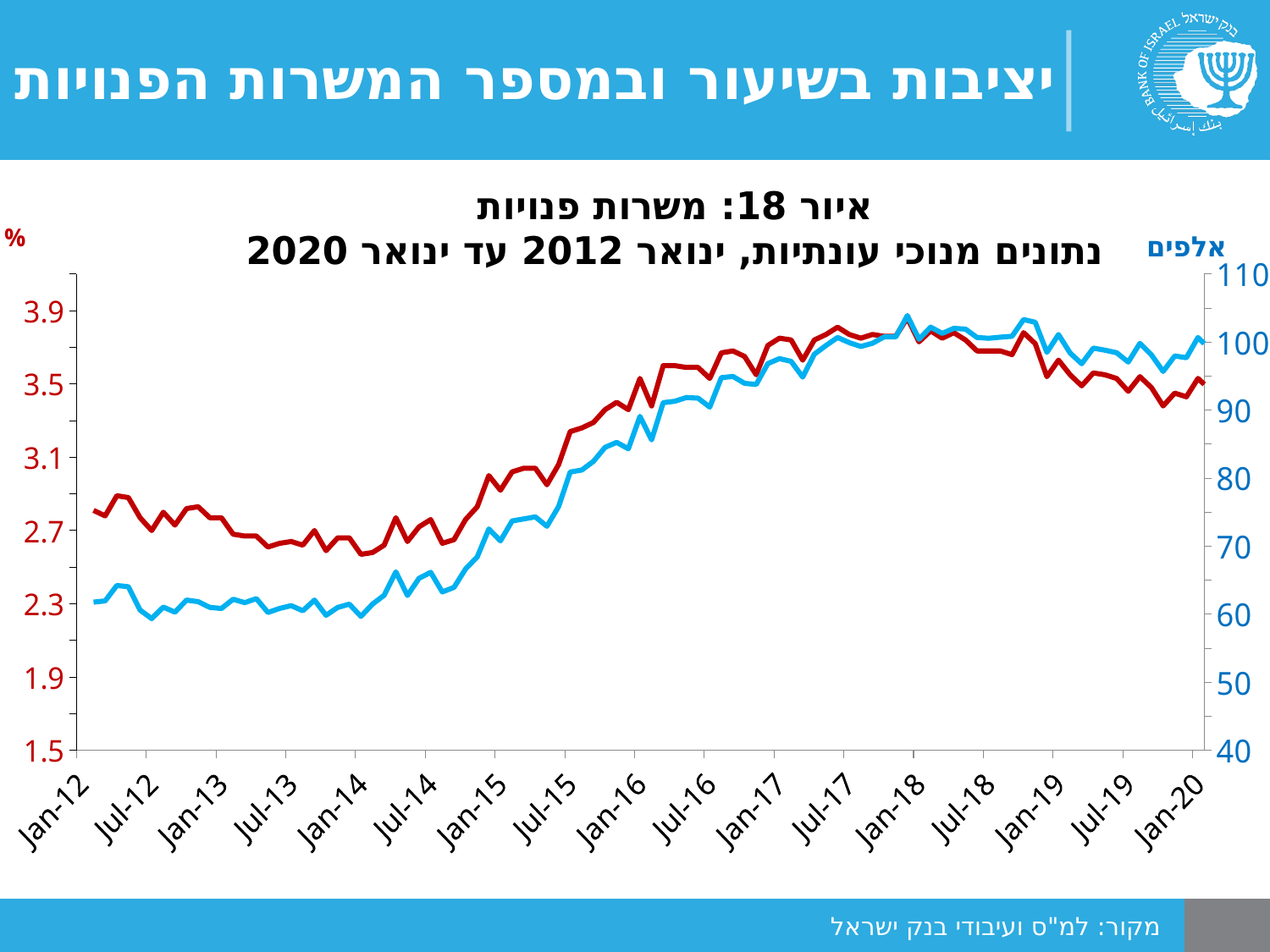
How many date labels are shown on the x axis? 17 How many lines are plotted on the chart? 2 Does the red line rise or fall between Jan-18 and Jan-20? fall Is the value of the red line at Jan-18 greater or less than 3.5? greater Is the value of the red line at Jul-13 greater or less than 3.1? less Is the value of the red line at Jan-12 greater or less than 2.3? greater Which is larger for the red line: the value at Jan-12 or the value at Jan-20? Jan-20 What kind of chart is shown on the slide? line chart Does the blue line rise or fall between Jan-14 and Jan-18? rise